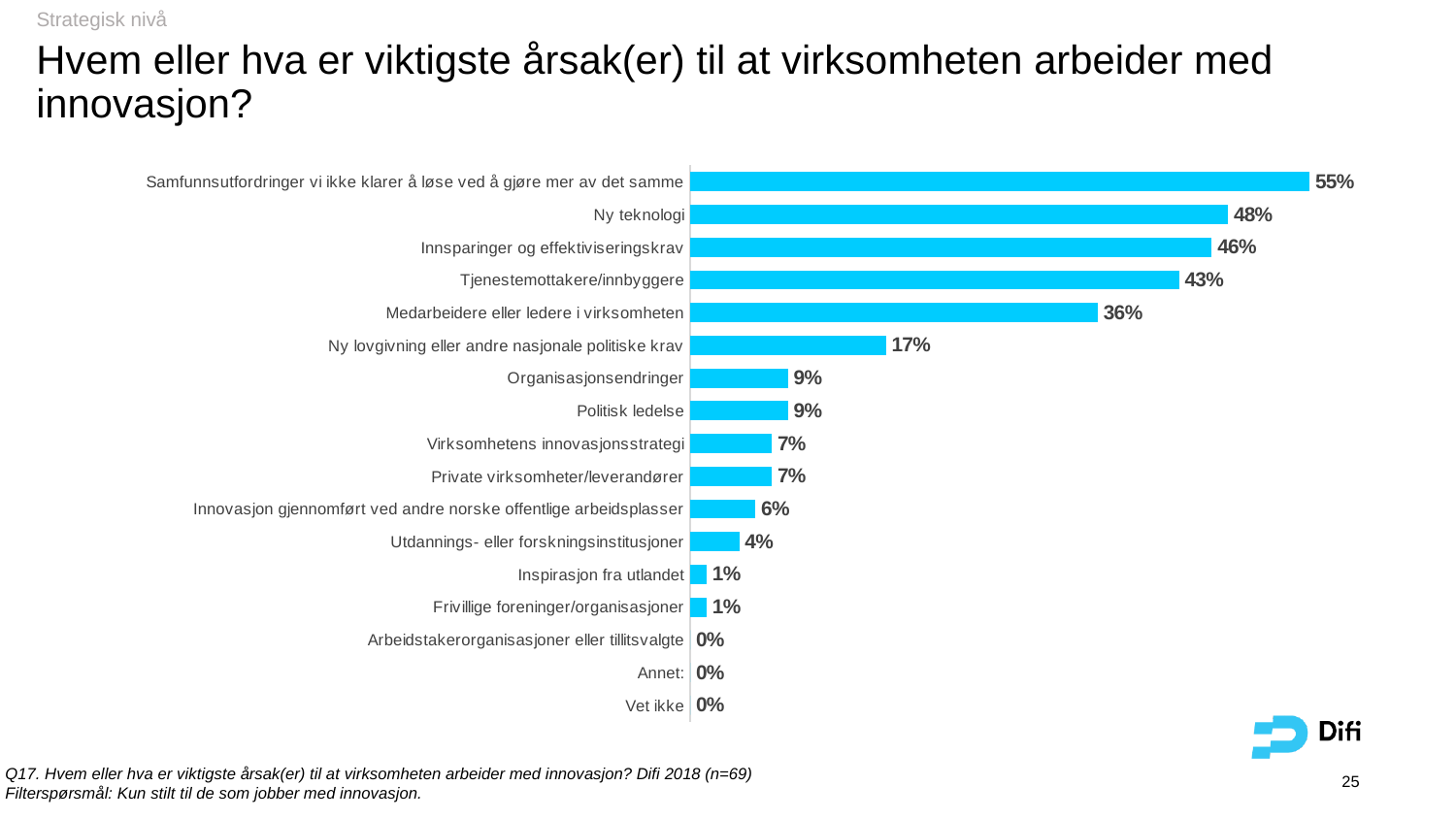
What is the value for "Medarbeidere eller ledere i virksomheten"? 36% What kind of chart is shown on the slide? bar chart Which has a larger value, "Innsparinger og effektiviseringskrav" or "Tjenestemottakere/innbyggere"? Innsparinger og effektiviseringskrav What is the value for "Inspirasjon fra utlandet"? 1% What is the value for "Ny lovgivning eller andre nasjonale politiske krav"? 17% What is the difference between the values for "Samfunnsutfordringer vi ikke klarer å løse ved å gjøre mer av det samme" and "Ny teknologi"? 7% What is the difference between the values for "Tjenestemottakere/innbyggere" and "Ny lovgivning eller andre nasjonale politiske krav"? 26% What is the value for "Utdannings- eller forskningsinstitusjoner"? 4% How many categories are shown in the chart? 17 What is the value for "Ny teknologi"? 48% How many categories have a value of 0%? 3 Which category has the highest value? Samfunnsutfordringer vi ikke klarer å løse ved å gjøre mer av det samme